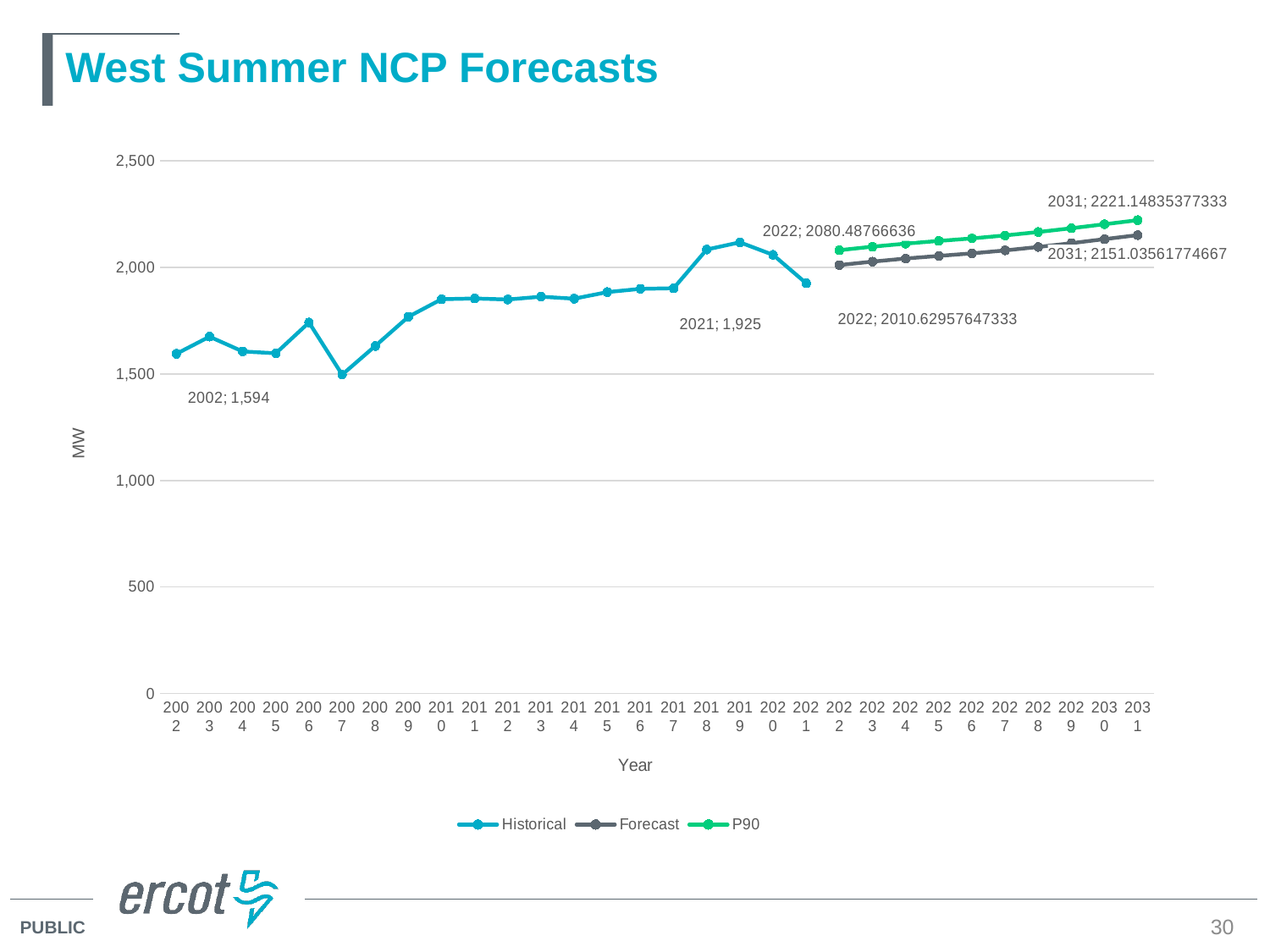
Does the Forecast series rise or fall from 2022 to 2031? Rise What is the difference between the Historical values for 2021 and 2002? 331 How many series does the legend list? 3 What is the P90 value for 2022? 2080.48766636 Which is larger in 2031, the P90 value or the Forecast value? P90 What is the P90 value for 2031? 2221.14835377333 What is the Historical value for 2021? 1,925 What is the Forecast value for 2022? 2010.62957647333 What is the Forecast value for 2031? 2151.03561774667 Is the Historical value for 2019 greater or less than 2,000? greater What is the Historical value for 2002? 1,594 What kind of chart is shown on the slide? Line chart